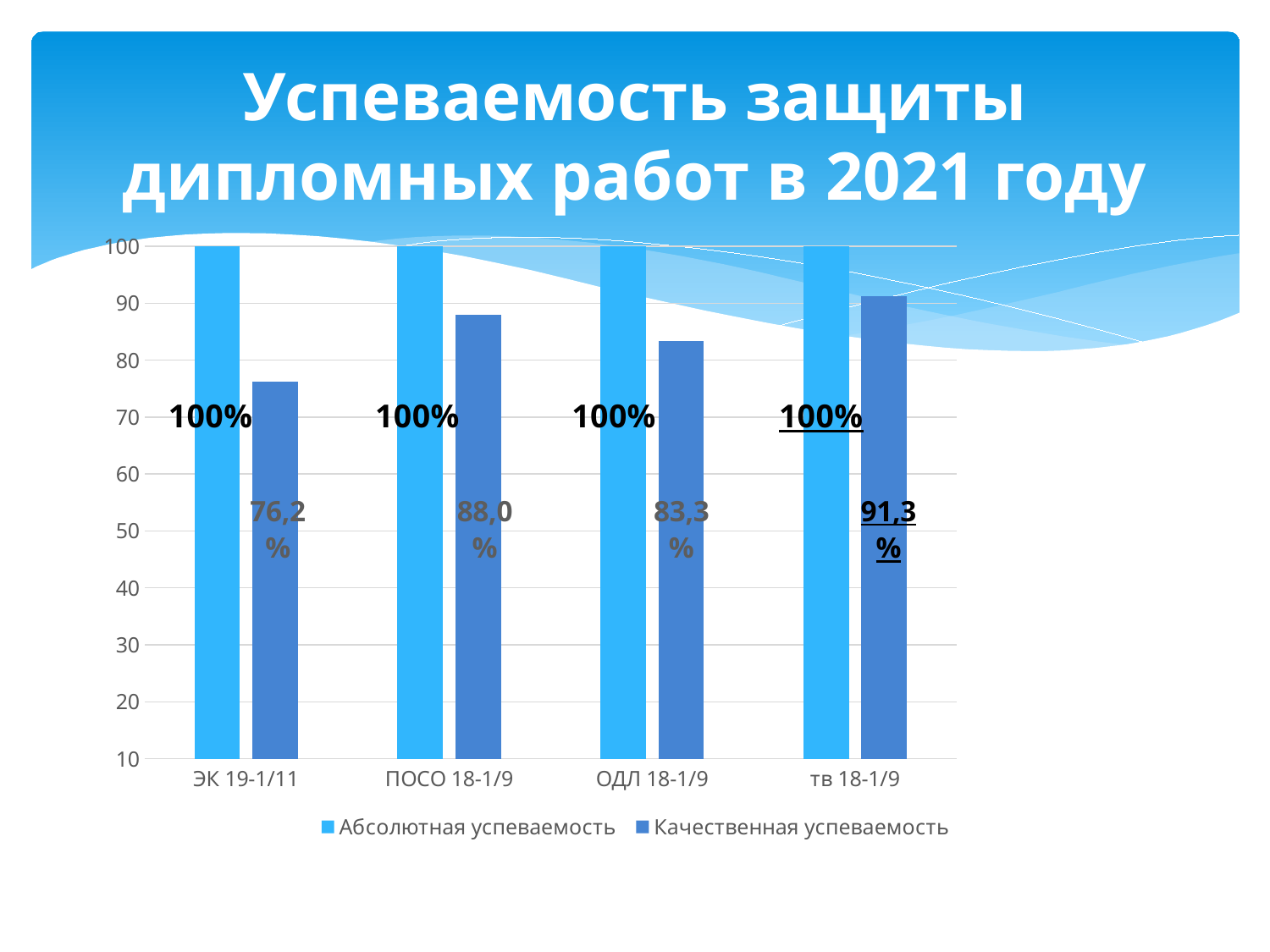
Is the Качественная успеваемость value for ЭК 19-1/11 greater or less than 80? less How many series does the legend list? 2 Which category has the lowest Качественная успеваемость? ЭК 19-1/11 What is the Абсолютная успеваемость value for тв 18-1/9? 100% What is the Качественная успеваемость value for ПОСО 18-1/9? 88,0% Which category has the highest Качественная успеваемость? тв 18-1/9 Which is larger, the Качественная успеваемость for ПОСО 18-1/9 or for ОДЛ 18-1/9? ПОСО 18-1/9 How many categories are shown on the x axis? 4 What is the Качественная успеваемость value for ЭК 19-1/11? 76,2% What is the title of the chart? Успеваемость защиты дипломных работ в 2021 году What is the Качественная успеваемость value for ОДЛ 18-1/9? 83,3% What type of chart is shown on the slide? bar chart